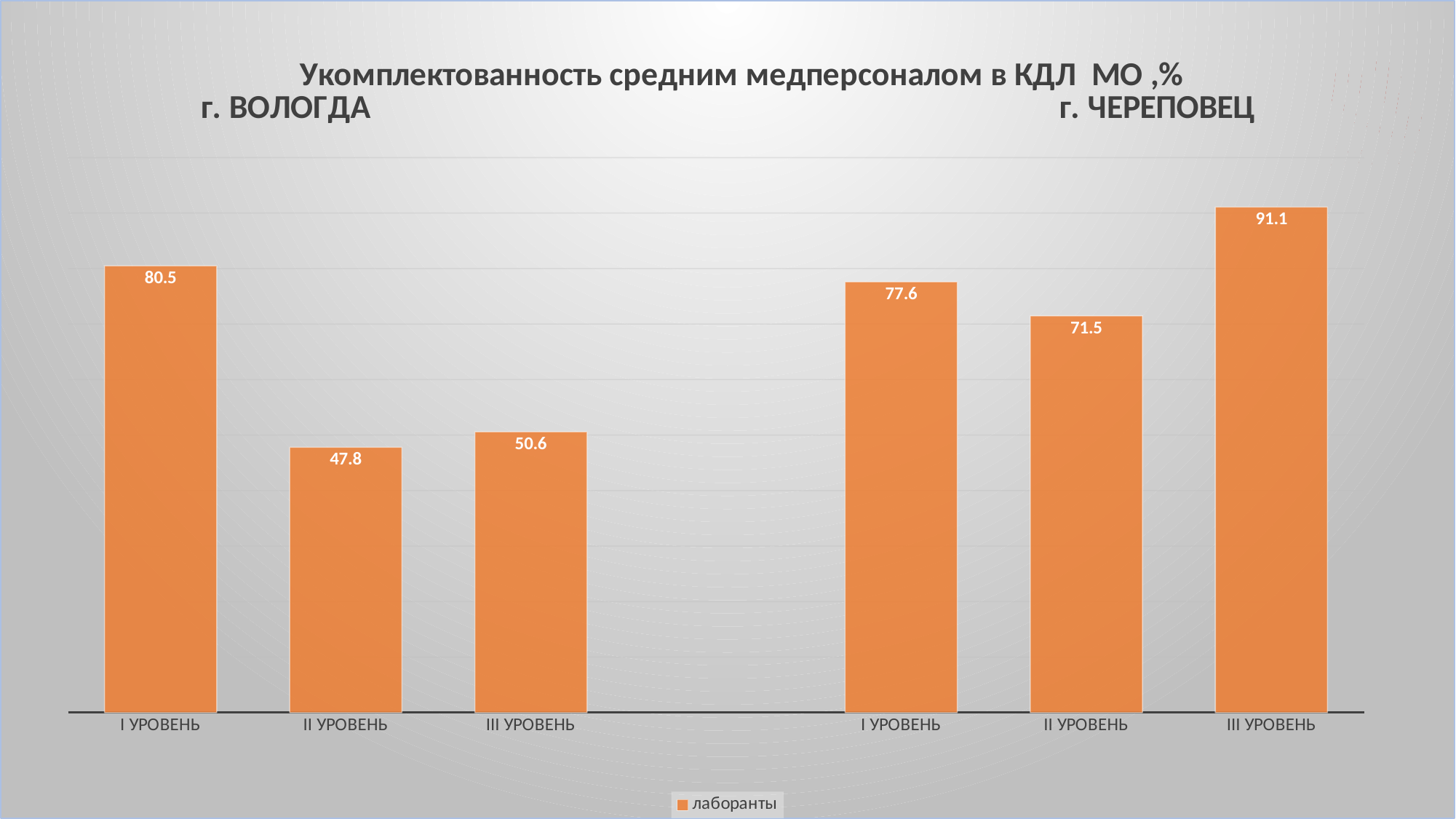
What is the value for II УРОВЕНЬ in г. ЧЕРЕПОВЕЦ? 71.5 What kind of chart is shown on the slide? Bar chart Which level has the lowest value in г. ВОЛОГДА? II УРОВЕНЬ What is the difference between III УРОВЕНЬ in г. ЧЕРЕПОВЕЦ and III УРОВЕНЬ in г. ВОЛОГДА? 40.5 Which is larger: I УРОВЕНЬ in г. ВОЛОГДА or I УРОВЕНЬ in г. ЧЕРЕПОВЕЦ? I УРОВЕНЬ in г. ВОЛОГДА What is the value for III УРОВЕНЬ in г. ВОЛОГДА? 50.6 What is the difference between I УРОВЕНЬ and II УРОВЕНЬ in г. ВОЛОГДА? 32.7 How many series does the legend list? 1 Which level has the highest value in г. ЧЕРЕПОВЕЦ? III УРОВЕНЬ How many bars are plotted on the chart in total? 6 What is the legend entry of the chart? лаборанты What is the value for I УРОВЕНЬ in г. ВОЛОГДА? 80.5